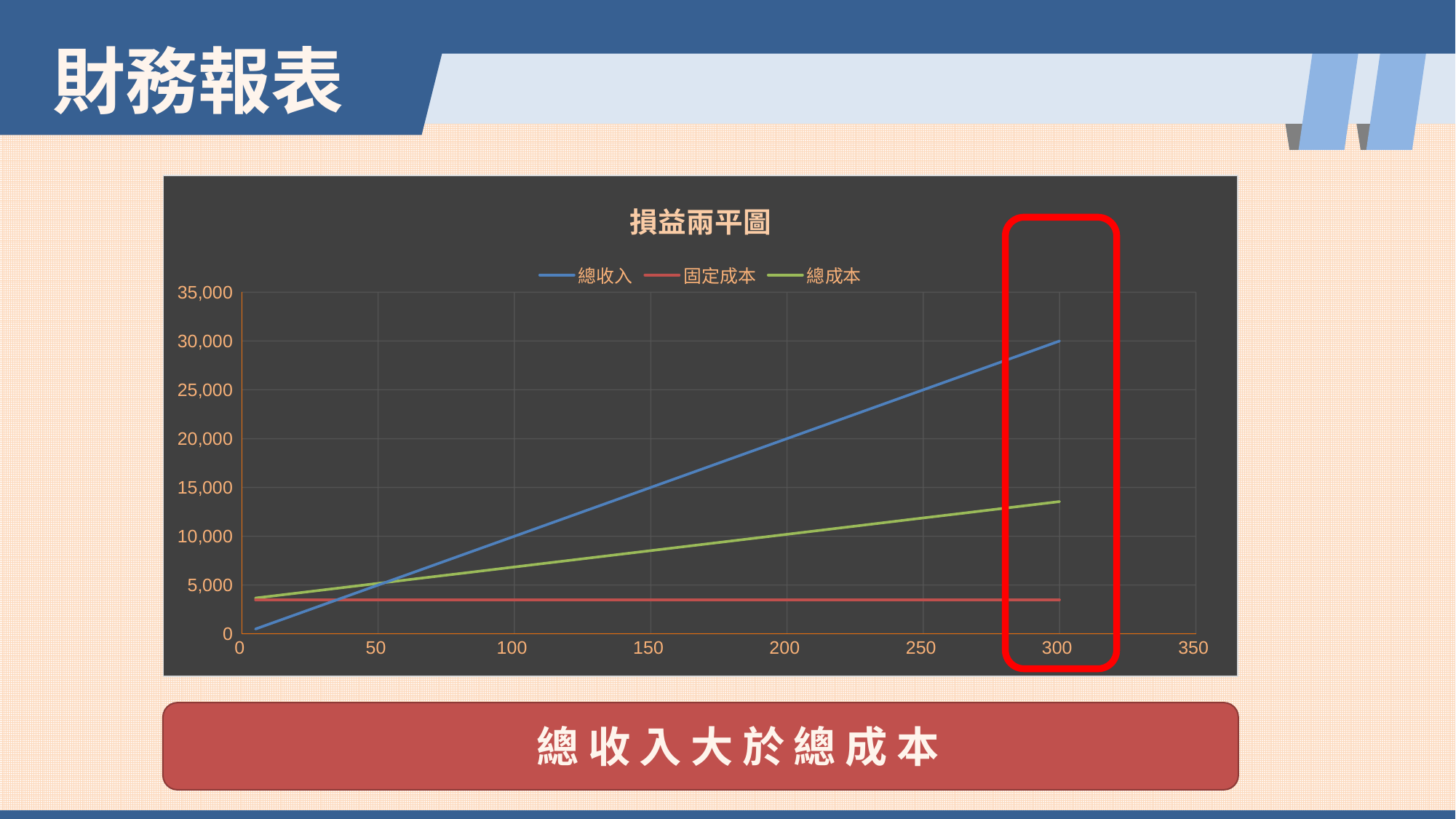
Does the 總成本 line rise or fall as the x axis increases? rises What is the title of the chart? 損益兩平圖 At x = 300, which is larger, 總收入 or 總成本? 總收入 Is the value of 總成本 at x = 300 greater or less than 15,000? less Which colour is the 總收入 line? blue What kind of chart is shown on the slide? line chart How many series does the legend list? 3 Is the value of 固定成本 at x = 300 greater or less than 5,000? less Does the 總收入 line rise or fall as the x axis increases? rises Which series has the highest value at x = 300? 總收入 Which series has the lowest value at x = 300? 固定成本 Is the value of 總收入 at x = 300 greater or less than 25,000? greater